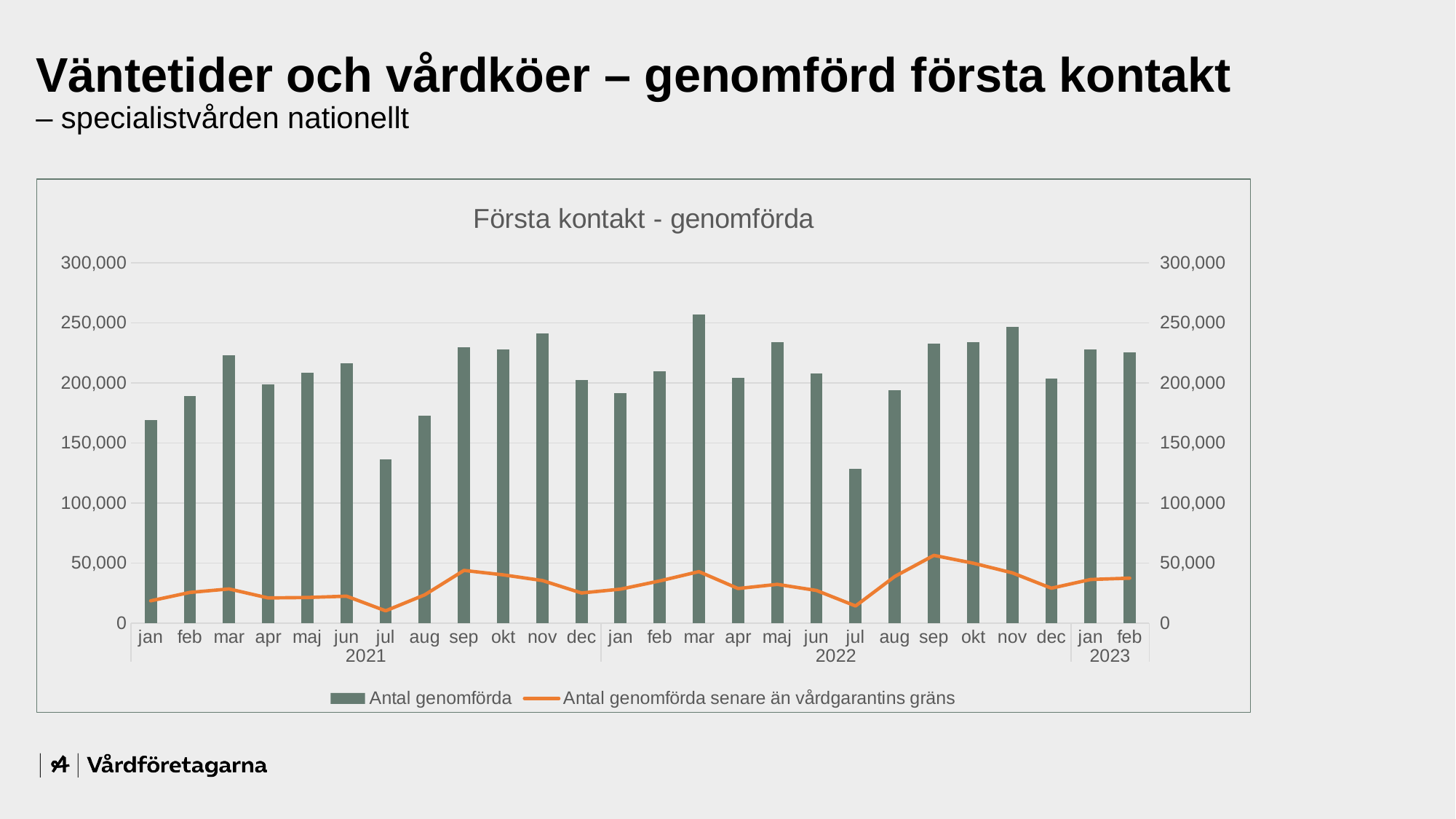
Is the Antal genomförda value for jul 2021 greater or less than 150,000? less What is the title of the chart? Första kontakt - genomförda Which is larger, the Antal genomförda bar for mar 2021 or for jul 2021? mar 2021 How many series does the legend list? 2 Does the line 'Antal genomförda senare än vårdgarantins gräns' rise or fall from jul 2022 to sep 2022? rise How many months are plotted along the x axis? 26 Is the Antal genomförda value for mar 2022 greater or less than 250,000? greater Is the Antal genomförda value for jan 2021 greater or less than 150,000? greater What kind of chart is shown on the slide? A combined bar and line chart In which month does the line 'Antal genomförda senare än vårdgarantins gräns' reach its highest point? sep 2022 Which month has the lowest bar for Antal genomförda? jul 2022 Which month has the highest bar for Antal genomförda? mar 2022